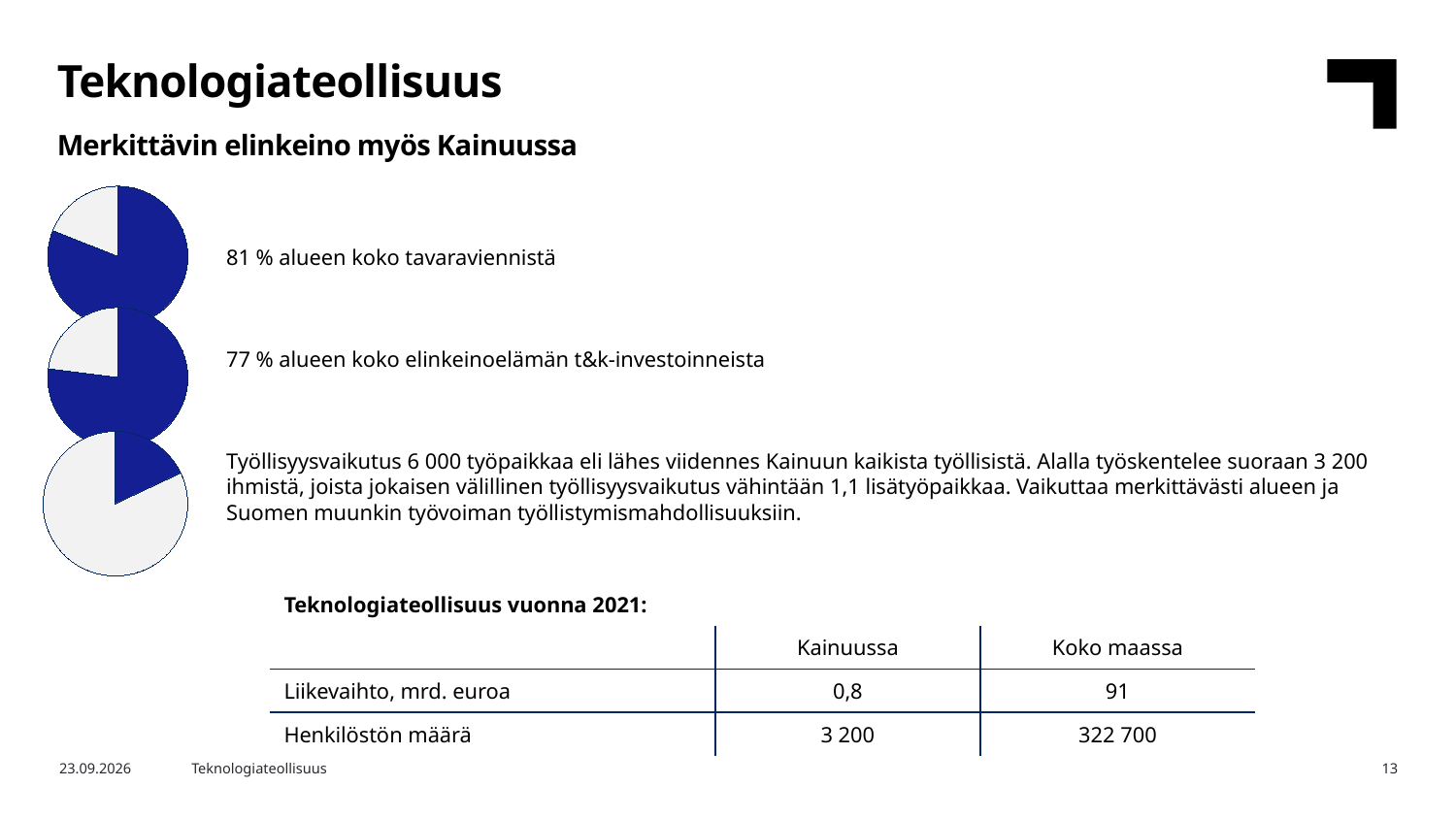
Which is larger: the share shown for goods exports (top pie) or the share shown for R&D investments (middle pie)? Goods exports (81 %) How many pie charts are on the slide? 3 What kind of charts are shown on the left side of the slide? Pie charts Which pie chart has the smallest dark blue slice: the top, middle or bottom one? Bottom What colour is used for the highlighted slice in each pie chart? Dark blue Which pie chart has the largest dark blue slice: the top, middle or bottom one? Top According to the text next to the middle pie chart, what share of the region's business R&D investments does the technology industry account for? 77 % What is the difference in percentage points between the share for goods exports (81 %) and the share for R&D investments (77 %)? 4 percentage points Is the dark blue slice of the top pie chart greater or less than 50% of the pie? greater What is the title of the slide containing the pie charts? Teknologiateollisuus Is the dark blue slice of the bottom pie chart greater or less than 50% of the pie? less According to the text next to the top pie chart, what share of the region's total goods exports does the technology industry account for? 81 %